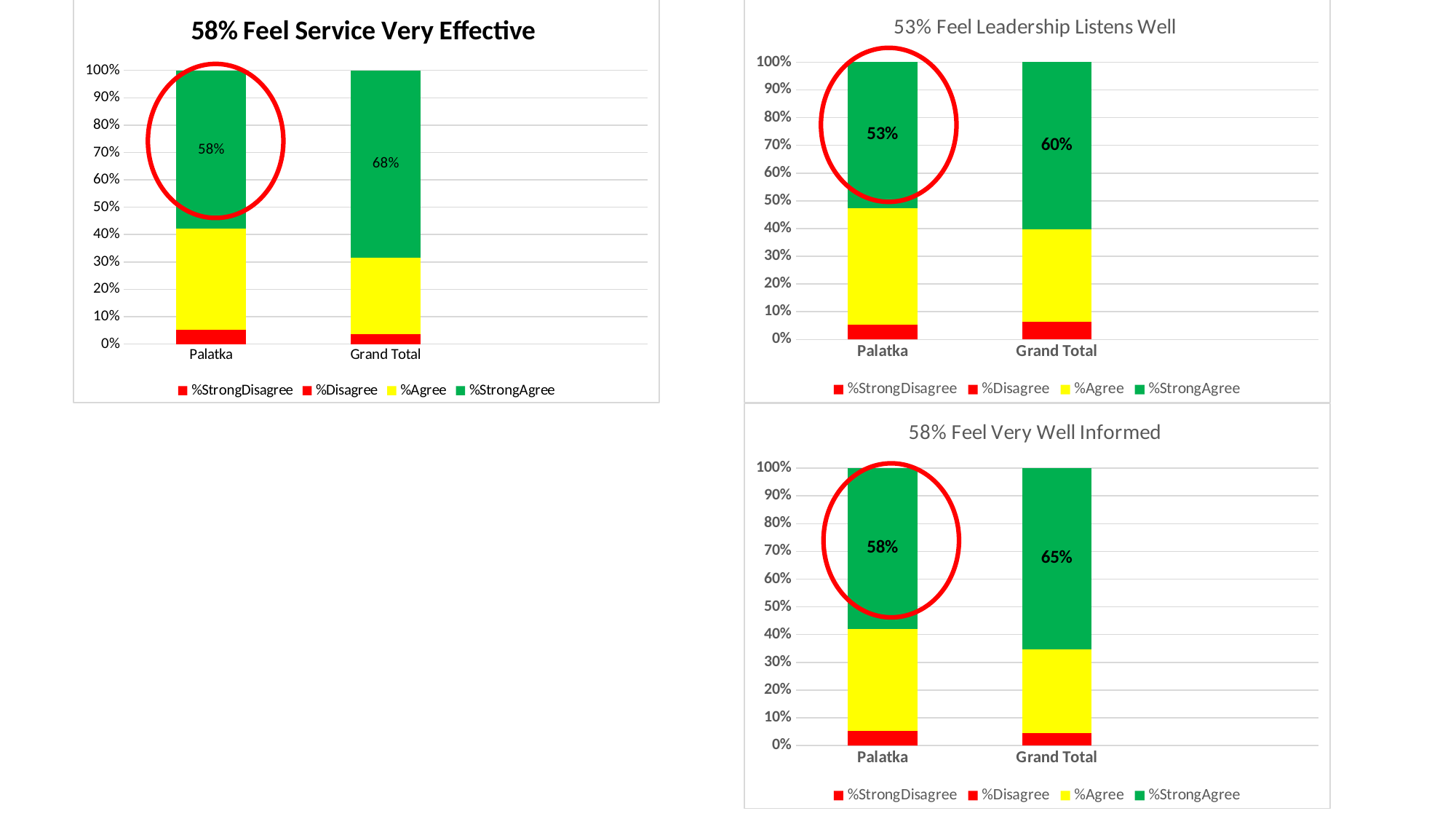
In the chart titled '58% Feel Very Well Informed', what is the %StrongAgree value for Grand Total? 65% How many categories are shown on the x axis of the chart titled '53% Feel Leadership Listens Well'? 2 In the chart titled '53% Feel Leadership Listens Well', which has the larger %StrongAgree value, Palatka or Grand Total? Grand Total In the chart titled '53% Feel Leadership Listens Well', which colour represents %StrongAgree? Green In the chart titled '58% Feel Service Very Effective', what is the difference between the %StrongAgree values for Grand Total and Palatka? 10% In the chart titled '58% Feel Very Well Informed', which category has the lowest %StrongAgree value? Palatka In the chart titled '58% Feel Service Very Effective', what is the %StrongAgree value for Grand Total? 68% In the chart titled '58% Feel Very Well Informed', what is the %StrongAgree value for Palatka? 58% In the chart titled '53% Feel Leadership Listens Well', what is the %StrongAgree value for Grand Total? 60% What kind of chart is the chart titled '58% Feel Very Well Informed'? Stacked bar chart In the chart titled '58% Feel Service Very Effective', what is the %StrongAgree value for Palatka? 58% How many series does the legend list in the chart titled '58% Feel Service Very Effective'? 4